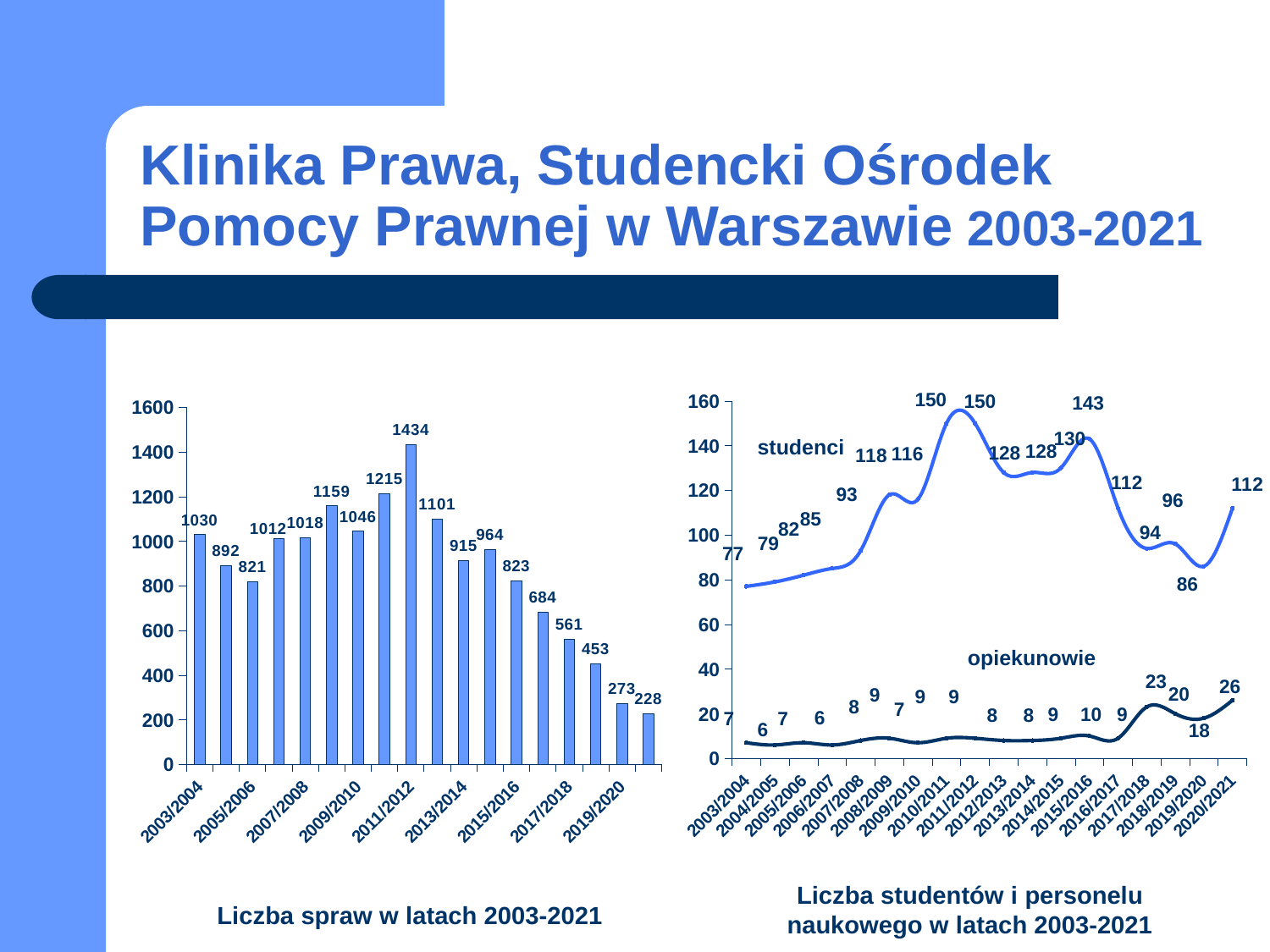
In the left chart 'Liczba spraw w latach 2003-2021', which is larger, the value for 2013/2014 or for 2015/2016? 2013/2014 In the left chart 'Liczba spraw w latach 2003-2021', do the values rise or fall from 2011/2012 to 2020/2021? fall What kind of chart is the right chart, 'Liczba studentów i personelu naukowego w latach 2003-2021'? line chart In the right chart 'Liczba studentów i personelu naukowego w latach 2003-2021', in which year is the opiekunowie value highest? 2020/2021 In the left chart 'Liczba spraw w latach 2003-2021', what is the value for 2019/2020? 273 In the left chart 'Liczba spraw w latach 2003-2021', how many bars are plotted? 18 What kind of chart is the left chart, 'Liczba spraw w latach 2003-2021'? bar chart In the left chart 'Liczba spraw w latach 2003-2021', which year has the highest number of cases? 2011/2012 In the left chart 'Liczba spraw w latach 2003-2021', what is the difference between the values for 2011/2012 and 2019/2020? 1161 In the right chart 'Liczba studentów i personelu naukowego w latach 2003-2021', how many series are plotted? 2 In the left chart 'Liczba spraw w latach 2003-2021', what is the value for 2003/2004? 1030 In the right chart 'Liczba studentów i personelu naukowego w latach 2003-2021', what is the value for studenci in 2020/2021? 112